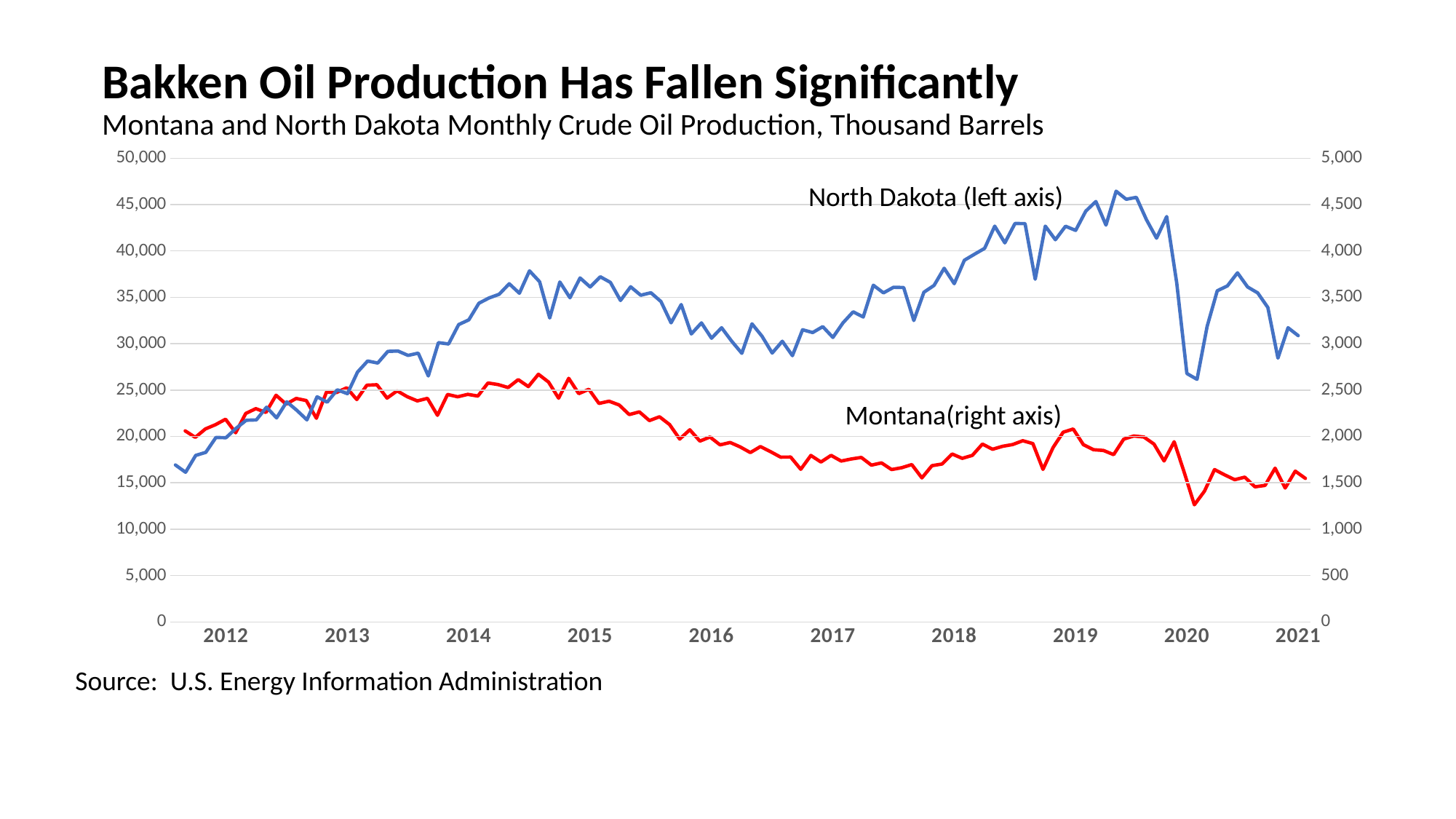
Does Montana production rise or fall between 2015 and 2017? fall What kind of chart is shown on the slide? line chart Does North Dakota production rise or fall between 2016 and 2019? rise Which series is plotted against the right axis? Montana Is the lowest value for Montana in 2020 greater or less than 1,500? less Is the peak value for Montana around 2014 greater or less than 2,500? greater What is the title of the chart? Bakken Oil Production Has Fallen Significantly Is the first plotted value for North Dakota at the start of the series greater or less than 20,000? less In which year does North Dakota production reach its highest point? 2019 How many data series are plotted on the chart? 2